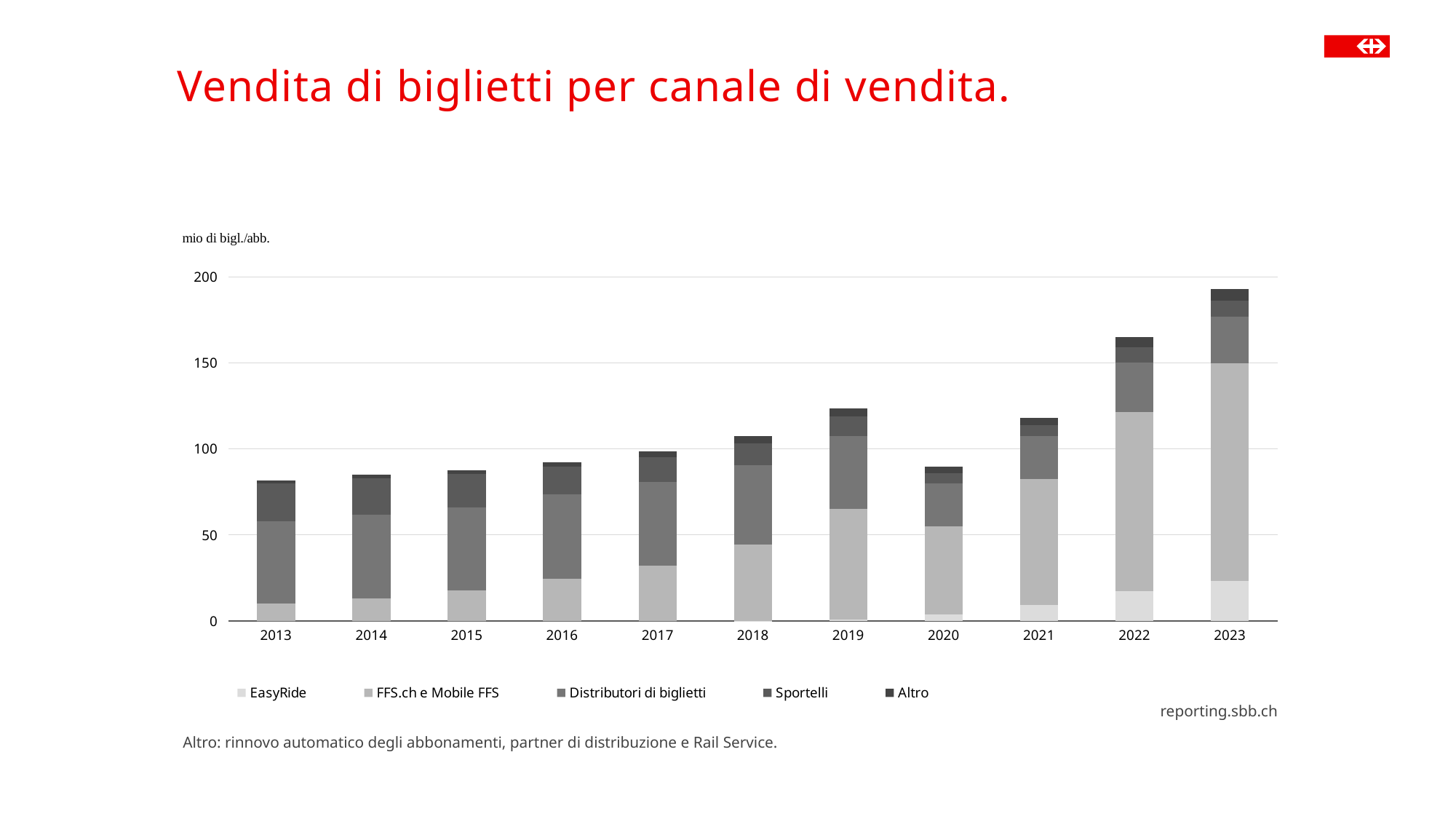
Is the total bar for 2019 greater or less than 100? greater How many years are shown on the x axis of the chart? 11 From 2013 to 2019, do the total bars rise or fall? rise What unit label is shown above the chart's y axis? mio di bigl./abb. How many series does the chart's legend list? 5 Which year has the larger total bar, 2022 or 2020? 2022 Is the total bar for 2023 greater or less than 150? greater What is the title of the chart on the slide? Vendita di biglietti per canale di vendita. Is the total bar for 2013 greater or less than 100? less Which year has the highest total bar in the chart? 2023 What kind of chart is shown on the slide? bar chart